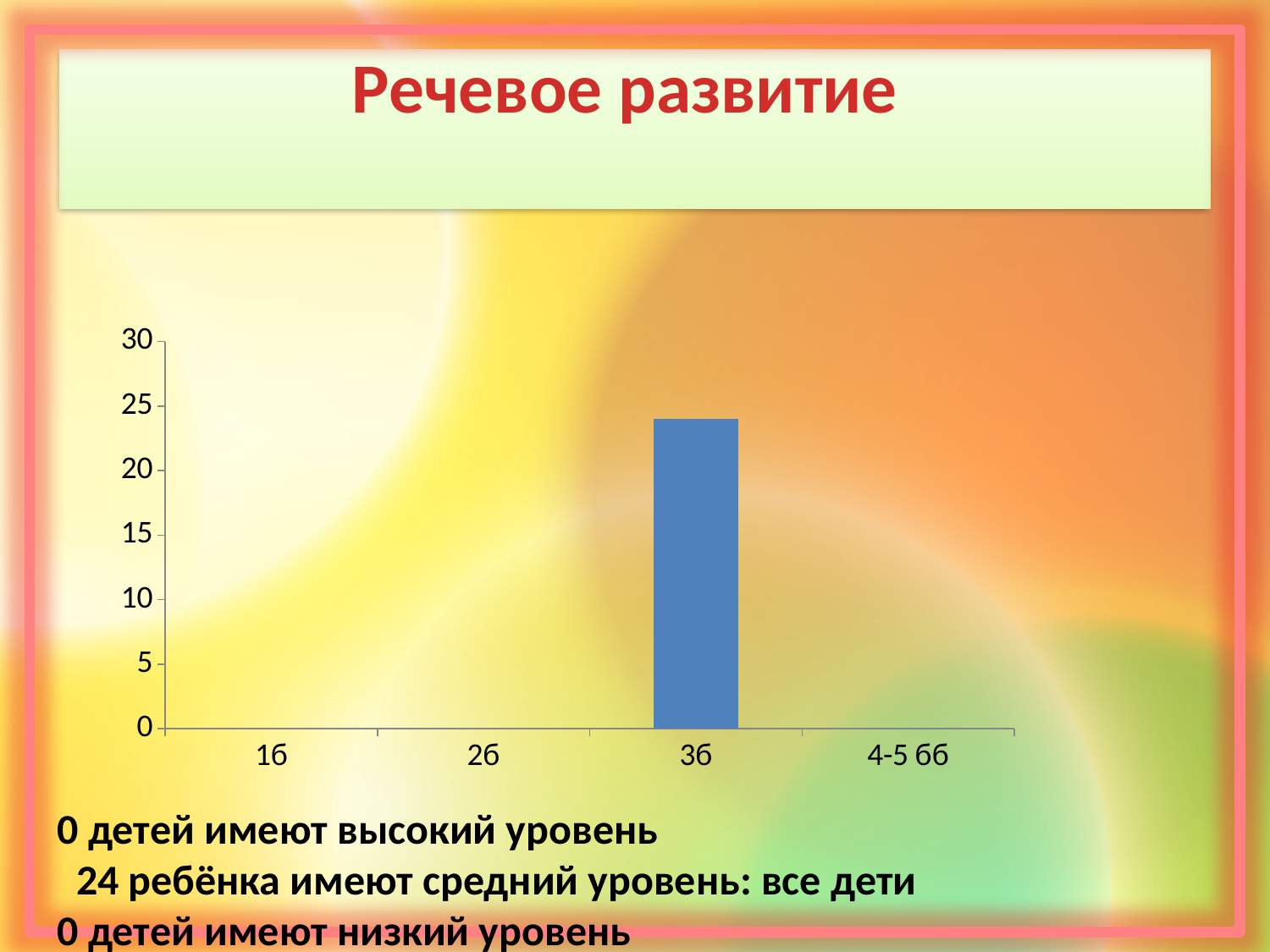
What kind of chart is shown on the slide? bar chart How many categories in the chart have a visible bar? 1 Is the value for 3б greater or less than 10? greater What is the title of the slide containing the chart? Речевое развитие Is the value for 3б greater or less than 25? less What is the value for 1б in the chart? 0 What colour is the bar in the chart? blue What is the value for 4-5 бб in the chart? 0 How many categories are shown on the x axis of the chart? 4 Which category has the highest value in the chart? 3б Which is larger, the value for 3б or the value for 2б? 3б Is the value for 3б greater or less than 20? greater